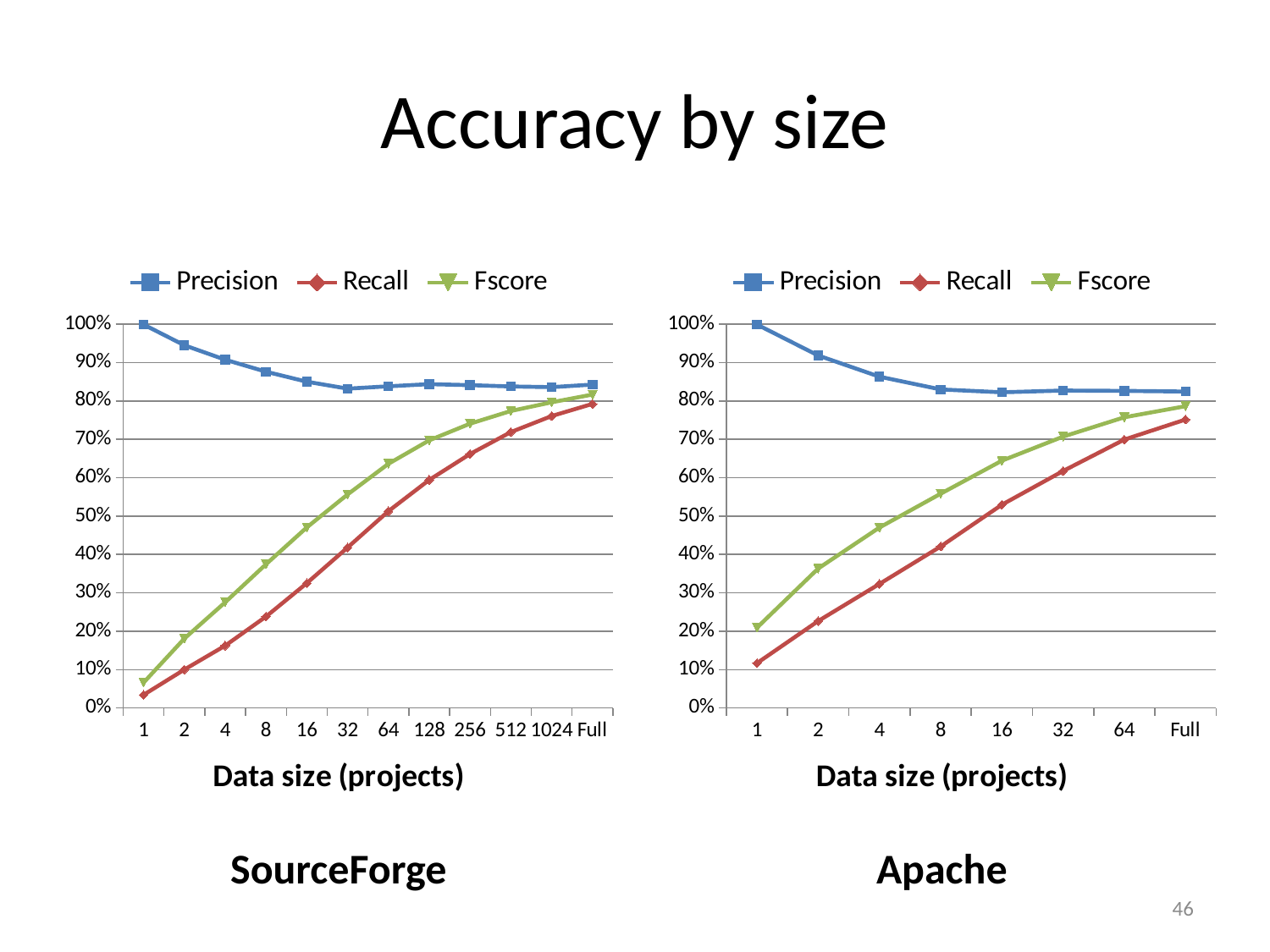
In the SourceForge chart, is the Fscore value at data size 32 greater or less than 50%? greater In the Apache chart, does the Precision series rise or fall as data size increases? fall In the Apache chart, is the Fscore value at data size 4 greater or less than 50%? less In the SourceForge chart, which is larger at data size 8: Precision or Recall? Precision In the SourceForge chart, does the Recall series rise or fall as data size increases? rise In the Apache chart, what is the Precision value at data size 1? 100% How many data size categories are shown on the x axis of the Apache chart? 8 In the SourceForge chart, is the Recall value at data size 1 greater or less than 10%? less What type of chart is the SourceForge chart? line chart How many data size categories are shown on the x axis of the SourceForge chart? 12 How many series does the legend of the Apache chart list? 3 In the SourceForge chart, what is the Precision value at data size 1? 100%